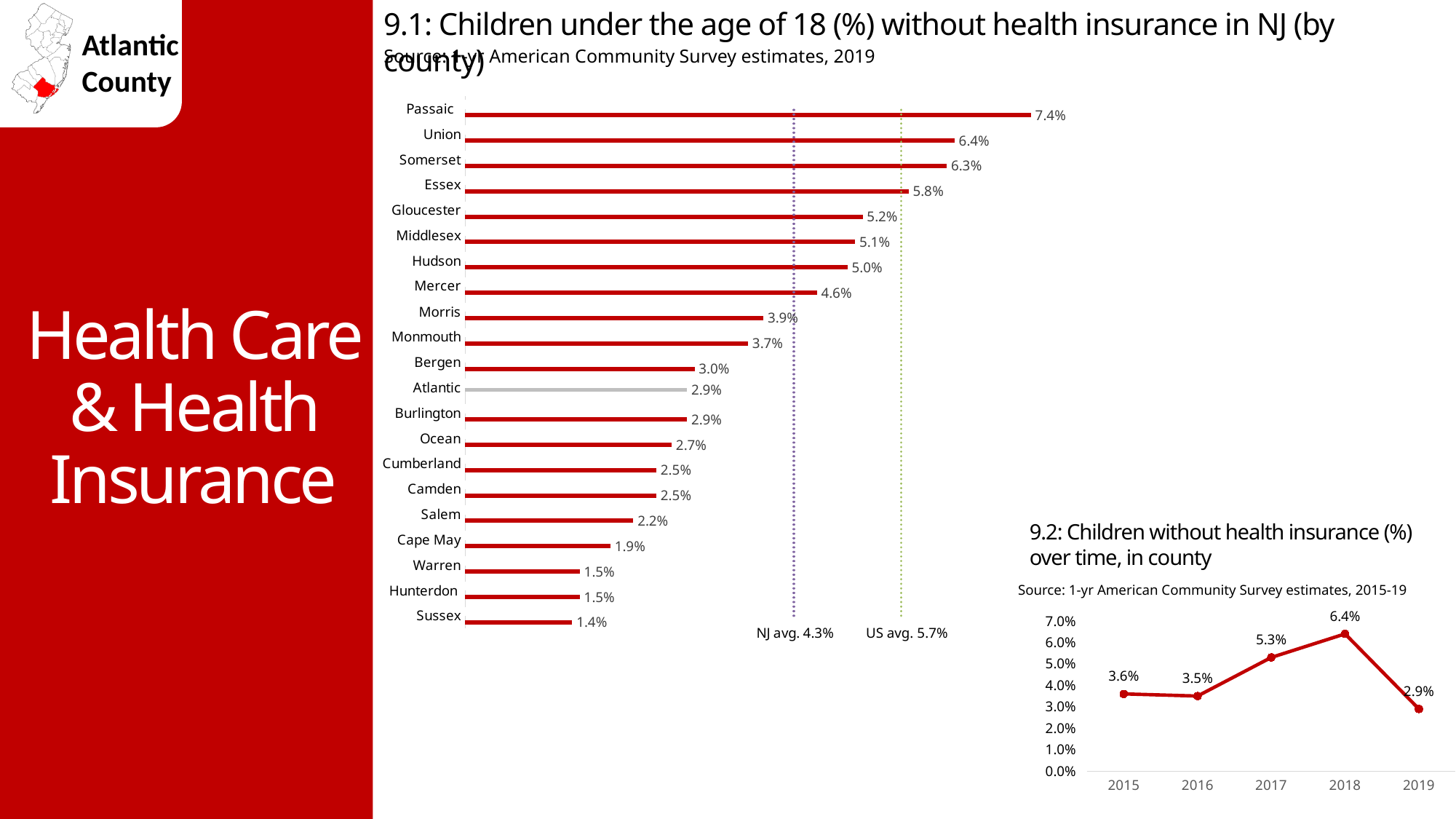
In chart 9.2 (children without health insurance over time, in county), which year has the lowest value? 2019 In chart 9.1 (children under 18 without health insurance by county), what is the value for Atlantic? 2.9% In chart 9.1 (children under 18 without health insurance by county), which is larger, the value for Mercer or the value for Bergen? Mercer In chart 9.2 (children without health insurance over time, in county), what is the value for 2018? 6.4% In chart 9.1 (children under 18 without health insurance by county), what is the NJ average shown by the dotted line? 4.3% In chart 9.1 (children under 18 without health insurance by county), what is the value for Passaic? 7.4% In chart 9.1 (children under 18 without health insurance by county), what is the difference between Passaic and Sussex? 6.0% What kind of chart is chart 9.2 (children without health insurance over time, in county)? Line chart In chart 9.2 (children without health insurance over time, in county), what is the difference between the 2018 and 2019 values? 3.5% In chart 9.1 (children under 18 without health insurance by county), how many counties are plotted? 21 In chart 9.1 (children under 18 without health insurance by county), which county has the highest value? Passaic In chart 9.1 (children under 18 without health insurance by county), which county has the lowest value? Sussex